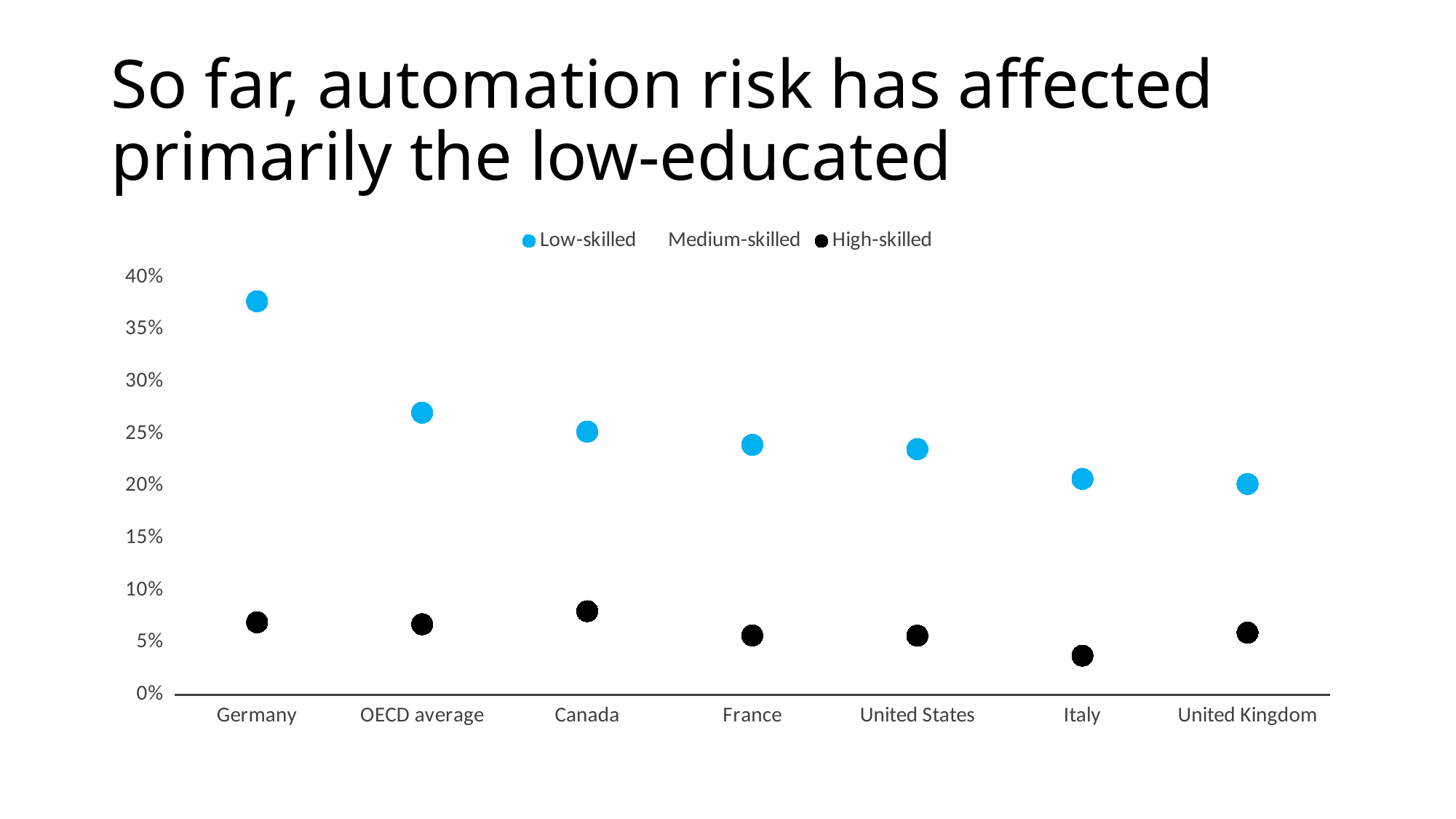
Do the Low-skilled values generally rise or fall moving from left to right along the x axis? fall What kind of chart is shown on the slide? Scatter (dot) chart Is the Low-skilled value for Germany greater or less than 35%? greater Which category has the lowest High-skilled value? Italy How many countries/categories are shown on the x axis? 7 How many series does the legend list? 3 Is the High-skilled value for Italy greater or less than 5%? less Which category has the highest High-skilled value? Canada Which category has the highest Low-skilled value? Germany What colour are the Low-skilled markers? Blue Which is larger, the Low-skilled value for OECD average or the Low-skilled value for Italy? OECD average Is the Low-skilled value for United Kingdom greater or less than 25%? less